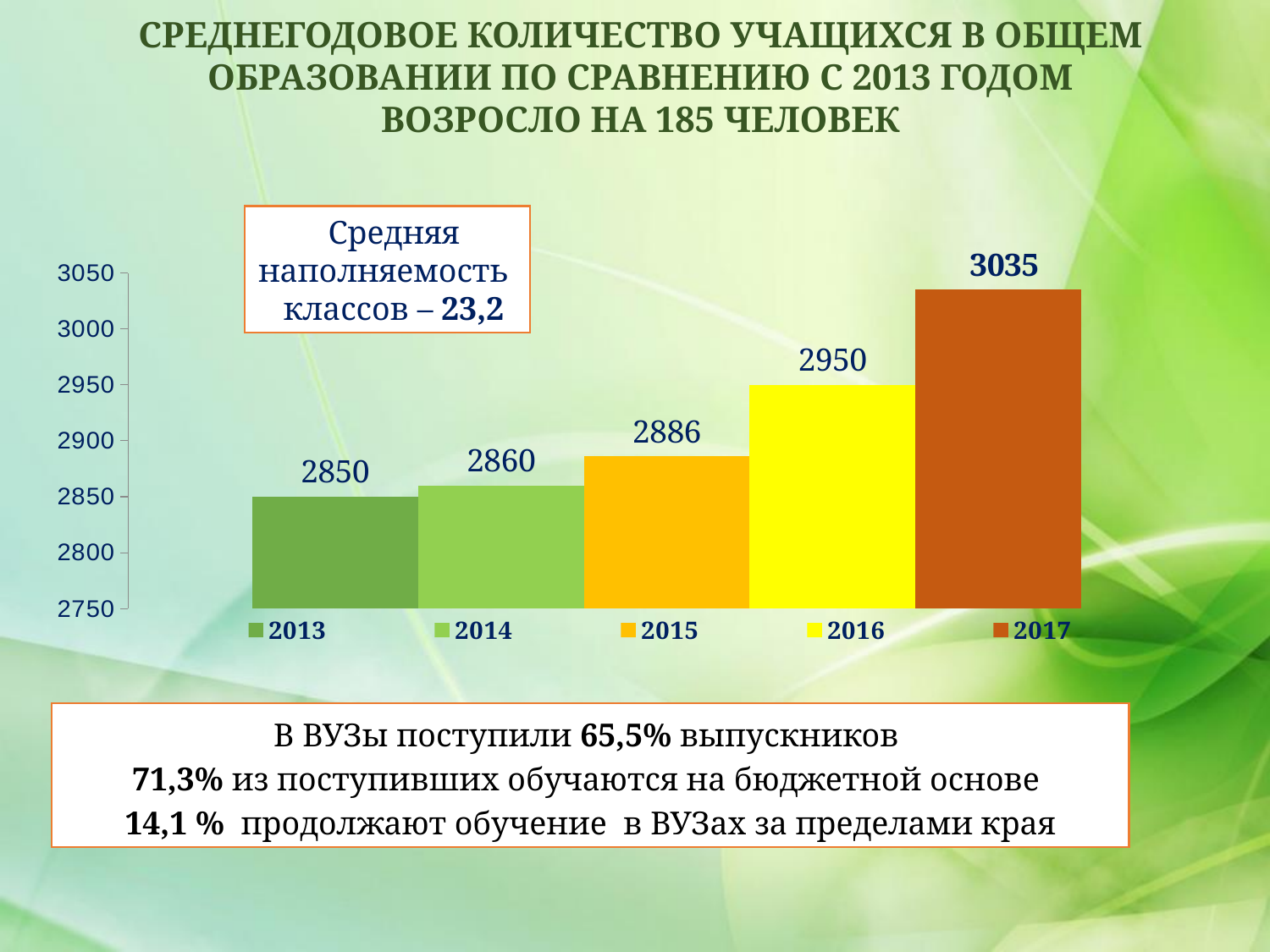
Do the values rise or fall from 2013 to 2017? rise Is the value for 2017 greater or less than 3000? greater What is the difference between the values for 2017 and 2013? 185 How many years are shown in the chart? 5 What is the value for 2016? 2950 What kind of chart is shown on the slide? bar chart What is the value for 2015? 2886 What is the difference between the values for 2016 and 2015? 64 Which is larger, the value for 2014 or the value for 2015? 2015 Which year has the highest value? 2017 Which year has the lowest value? 2013 What is the value for 2013? 2850